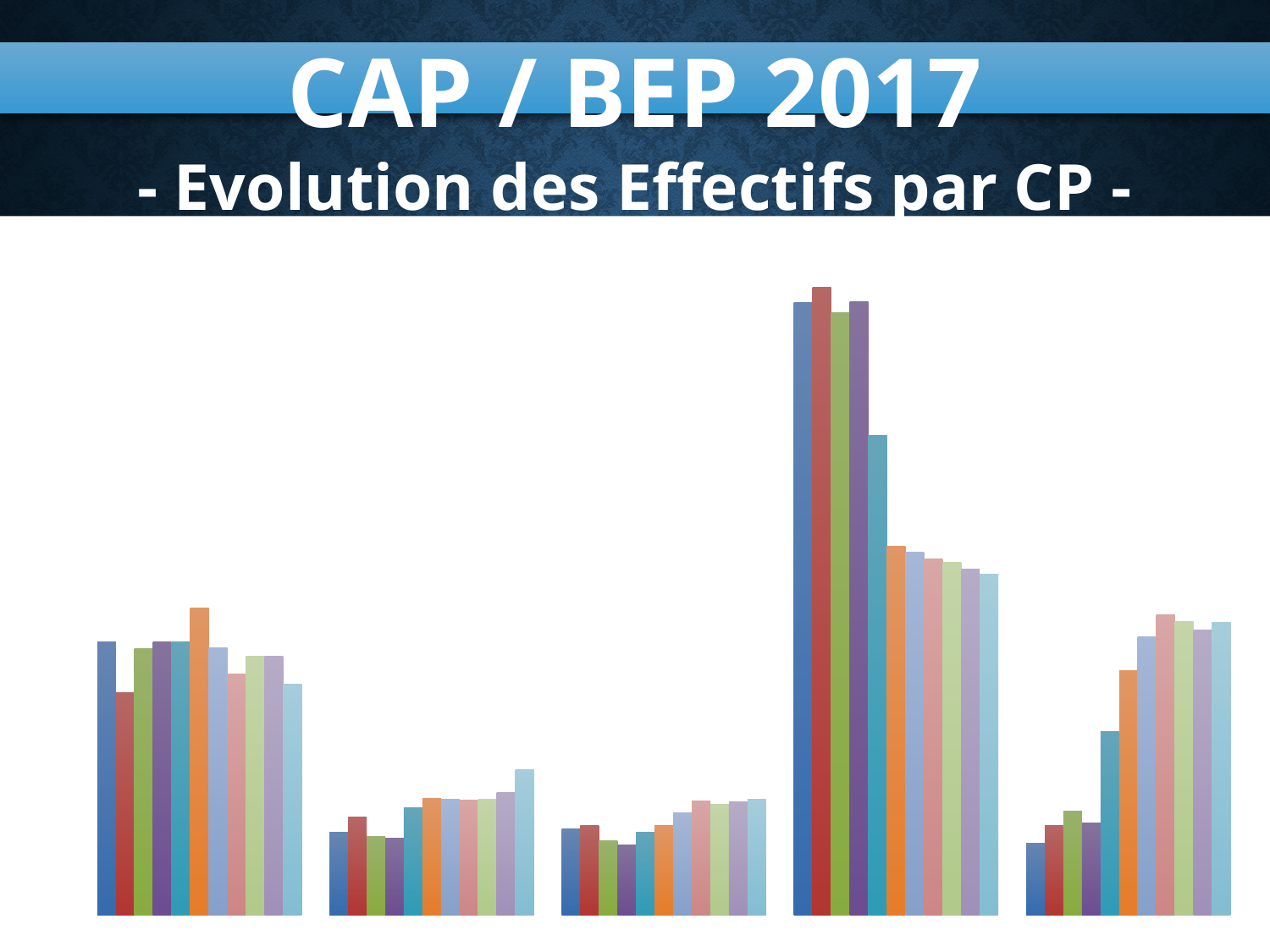
How many groups of bars are plotted in the chart? 5 Within the fourth group from the left, do the bars rise or fall from left to right? fall Which group of bars, counted from the left, contains the tallest bars in the chart? the fourth group Which group of bars, counted from the left, has the lowest bars overall? the third group Within the fifth (rightmost) group, do the bars rise or fall from left to right? rise Is the tallest bar in the second group taller or shorter than the tallest bar in the fifth group? shorter How many bars are there in each group of the chart? 11 Is the tallest bar in the first (leftmost) group taller or shorter than the tallest bar in the fourth group? shorter What kind of chart is shown on the slide? bar chart What is the title shown above the chart? CAP / BEP 2017 - Evolution des Effectifs par CP - Does the chart display a legend? No